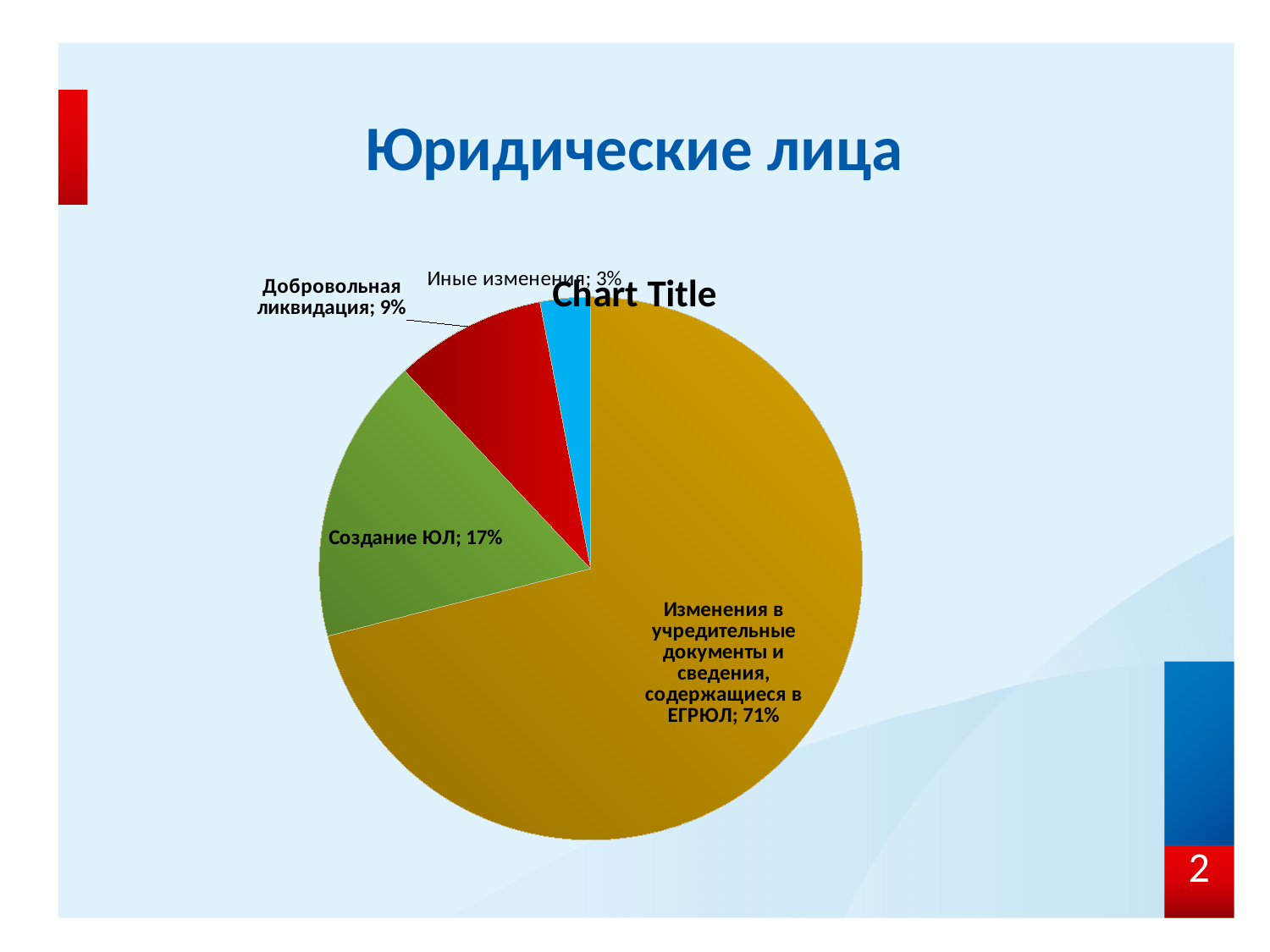
What is the title printed on the chart? Chart Title How many slices does the pie chart have? 4 Which is larger, the share for "Создание ЮЛ" or the share for "Добровольная ликвидация"? Создание ЮЛ What kind of chart is shown on the slide? pie chart What share of the pie does "Создание ЮЛ" have? 17% What is the difference in percentage points between "Создание ЮЛ" and "Добровольная ликвидация"? 8 What share of the pie does "Добровольная ликвидация" have? 9% Which category has the largest slice of the pie? Изменения в учредительные документы и сведения, содержащиеся в ЕГРЮЛ What colour is the slice for "Создание ЮЛ"? green What share of the pie does "Изменения в учредительные документы и сведения, содержащиеся в ЕГРЮЛ" have? 71% What share of the pie does "Иные изменения" have? 3% Which category has the smallest slice of the pie? Иные изменения